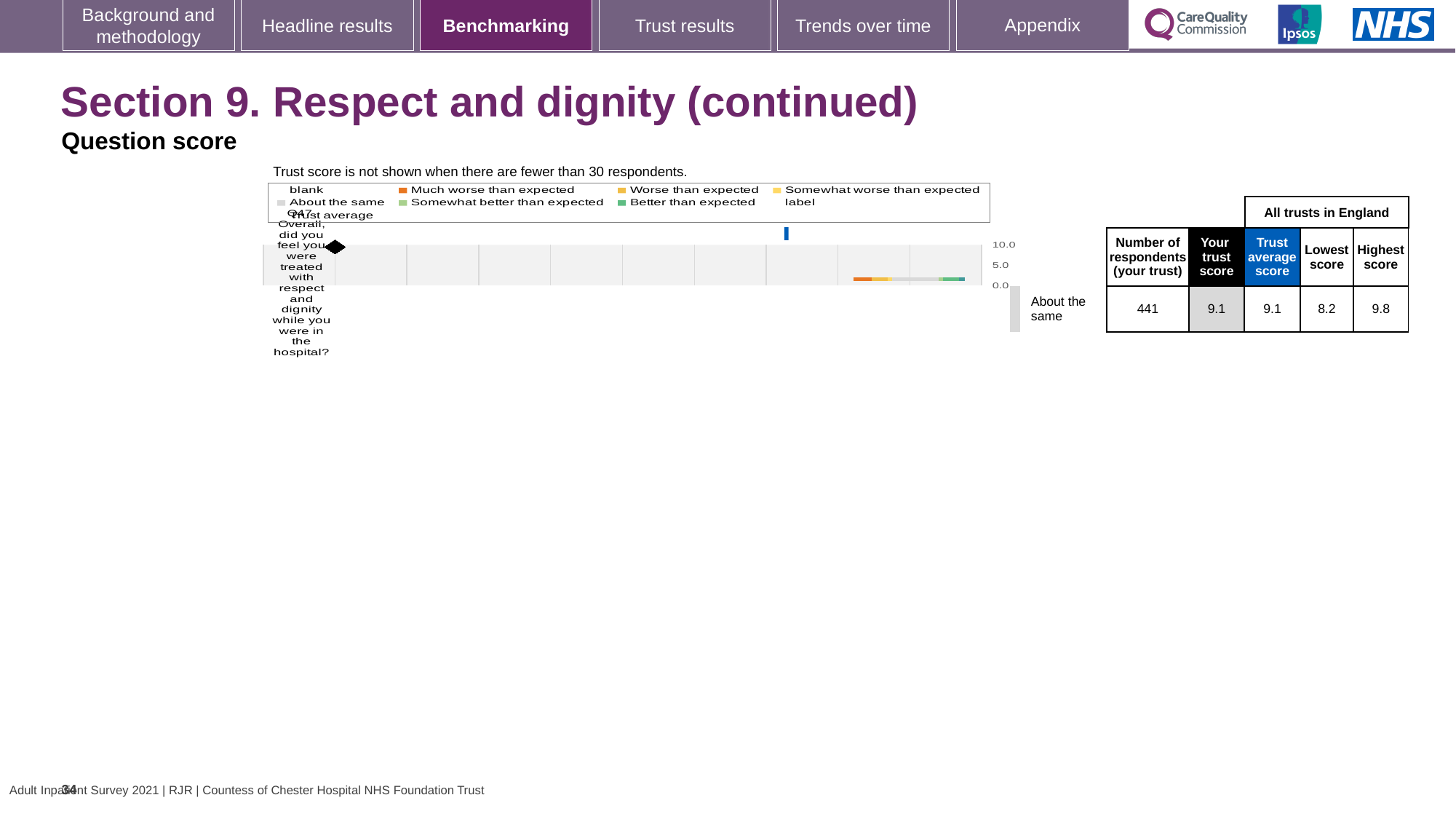
What is the trust score for Q47 shown in the table? 9.1 Is the trust score for Q47 greater or less than 5.0? greater What is the highest value shown on the chart's numeric axis? 10.0 What kind of chart is shown on the slide? bar chart Which question number is plotted on the chart? Q47 What is the difference between the highest score and the lowest score for Q47? 1.6 How many questions are plotted on the chart? 1 What is the lowest score for Q47 across all trusts in England? 8.2 How many respondents answered Q47 for this trust? 441 What is the trust average score for Q47 across all trusts in England? 9.1 What benchmark category is shown for Q47 next to the chart? About the same What is the highest score for Q47 across all trusts in England? 9.8